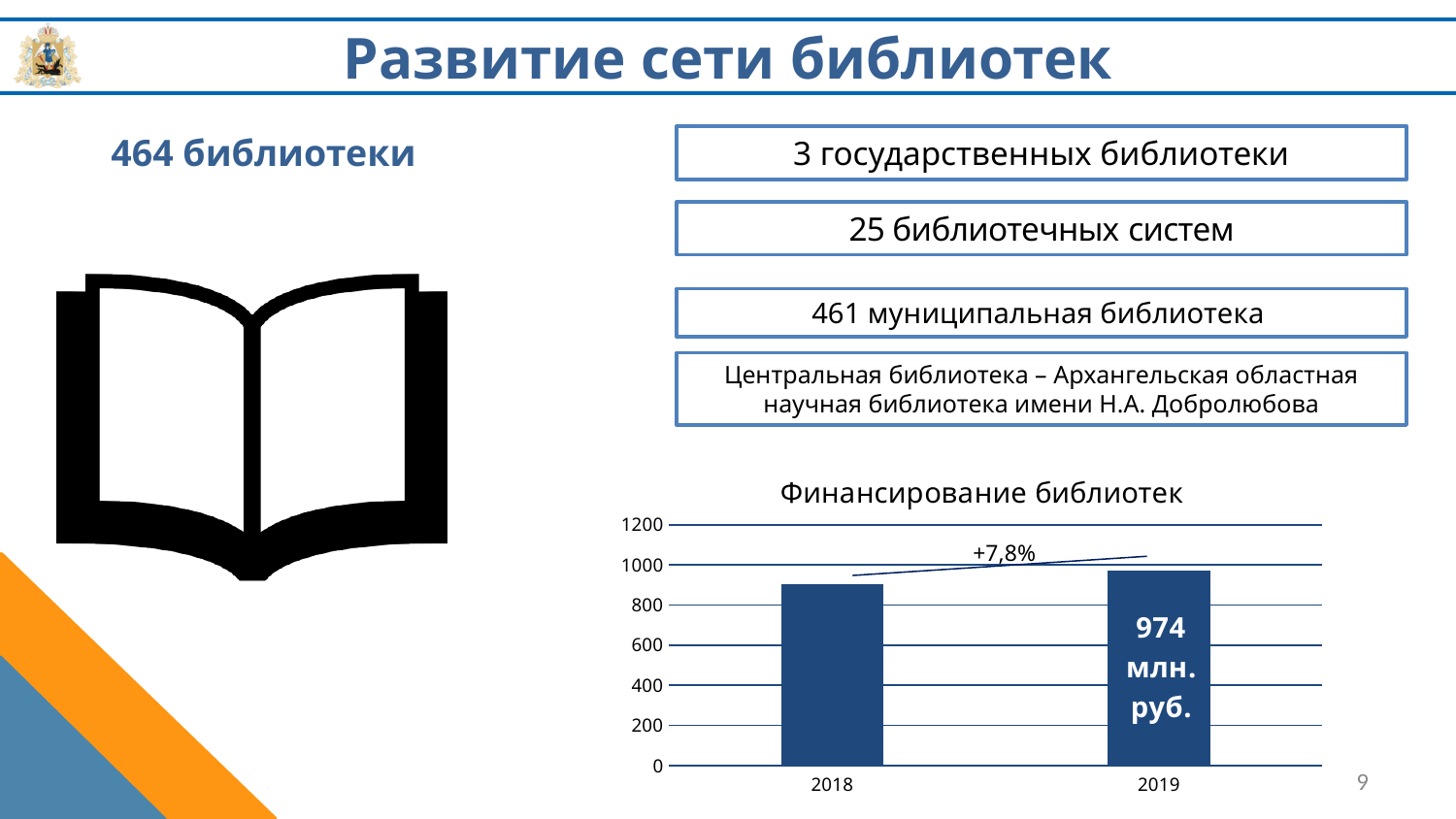
Which year has the lower bar in the chart? 2018 What value is printed on the bar for 2019? 974 млн. руб. What is the title of the chart on the slide? Финансирование библиотек Do the values rise or fall from 2018 to 2019? rise Which year has the higher bar in the chart? 2019 How many years are shown on the x axis of the chart? 2 What kind of chart is shown under the title "Финансирование библиотек"? bar chart Is the value for 2018 greater or less than 800? greater What is the highest tick value shown on the y axis of the chart? 1200 Is the value for 2018 greater or less than 1000? less Is the bar for 2018 taller or shorter than the bar for 2019? shorter What percentage change is annotated between the 2018 and 2019 bars? +7,8%